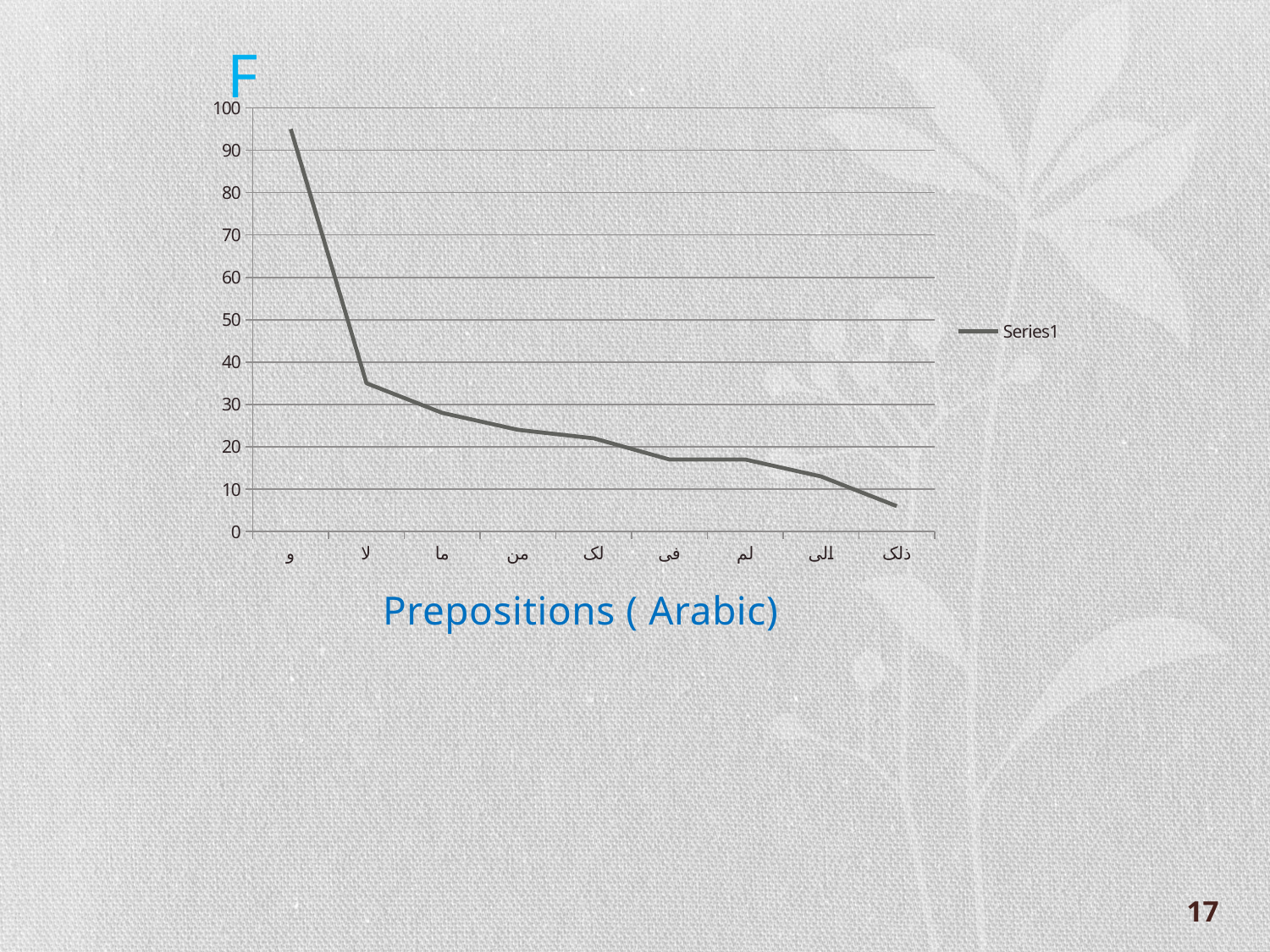
Is the value for و greater or less than 90? greater How many categories are plotted along the x axis? 9 Which category has the lowest value? ذلك What is the title of the x axis? Prepositions ( Arabic) What is the name of the series shown in the legend? Series1 Which category has the highest value? و What kind of chart is shown on the slide? line chart Which has the larger value, و or لا? و How many series does the legend list? 1 Do the values rise or fall moving from left to right along the x axis? fall Is the value for ذلك greater or less than 10? less Is the value for لا greater or less than 40? less